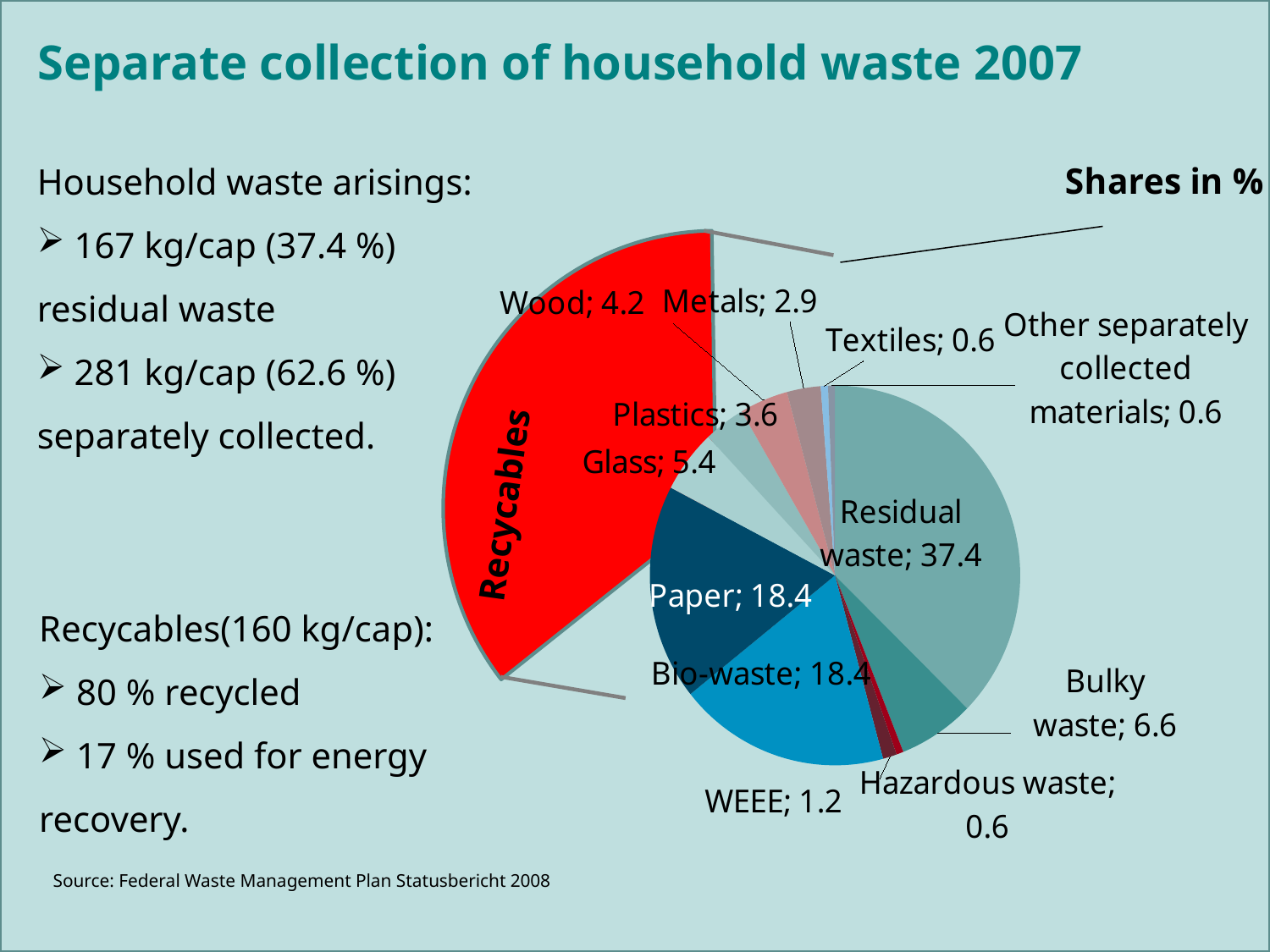
What share does Residual waste have in the pie chart? 37.4 What is the value labelled for WEEE in the pie chart? 1.2 What unit does the chart's heading say the shares are given in? % How many slices does the pie chart have? 12 What type of chart is shown on the slide? Pie chart What is the difference between the shares of Residual waste and Paper in the pie chart? 19.0 Which is larger in the pie chart, Bulky waste or Glass? Bulky waste What is the value shown for Bulky waste in the pie chart? 6.6 Which category has the largest slice in the pie chart? Residual waste Which is larger in the pie chart, Wood or Metals? Wood What is the difference between the shares of Glass and Plastics in the pie chart? 1.8 What share is shown for Glass in the pie chart? 5.4